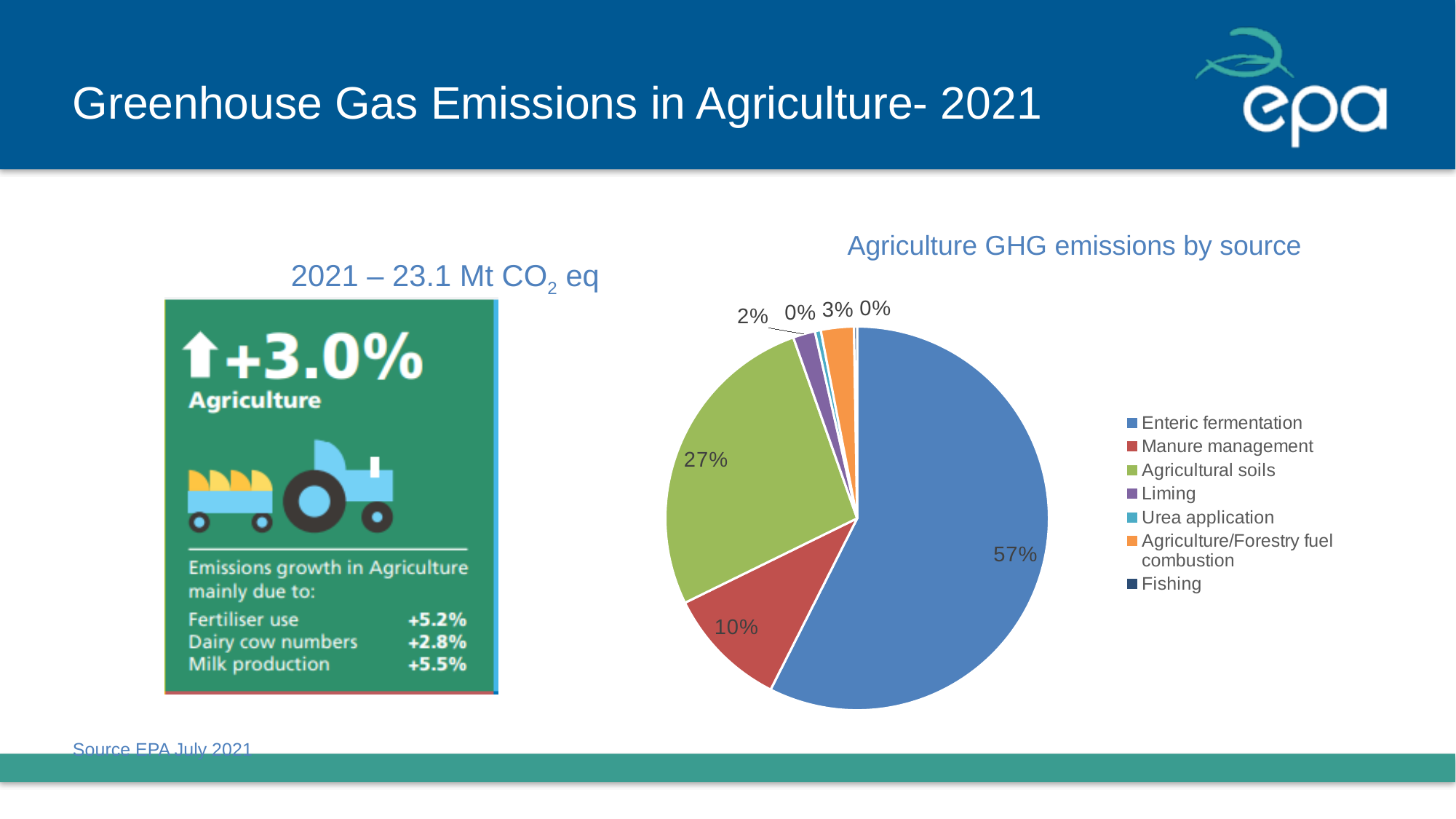
In the pie chart, what share is shown for Liming? 2% What kind of chart is shown under the title "Agriculture GHG emissions by source"? Pie chart What is the title of the pie chart on the slide? Agriculture GHG emissions by source In the pie chart, what share of agriculture GHG emissions comes from Enteric fermentation? 57% Which source accounts for the largest share of agriculture GHG emissions in the pie chart? Enteric fermentation In the pie chart, how many percentage points larger is the Enteric fermentation share than the Agricultural soils share? 30 percentage points In the pie chart, which is larger: the share for Agricultural soils or the share for Manure management? Agricultural soils In the pie chart, what share of agriculture GHG emissions comes from Manure management? 10% In the pie chart legend, which source is shown in green? Agricultural soils In the pie chart, what share of agriculture GHG emissions comes from Agricultural soils? 27% How many sources does the legend of the pie chart list? 7 In the pie chart, what share is shown for Agriculture/Forestry fuel combustion? 3%